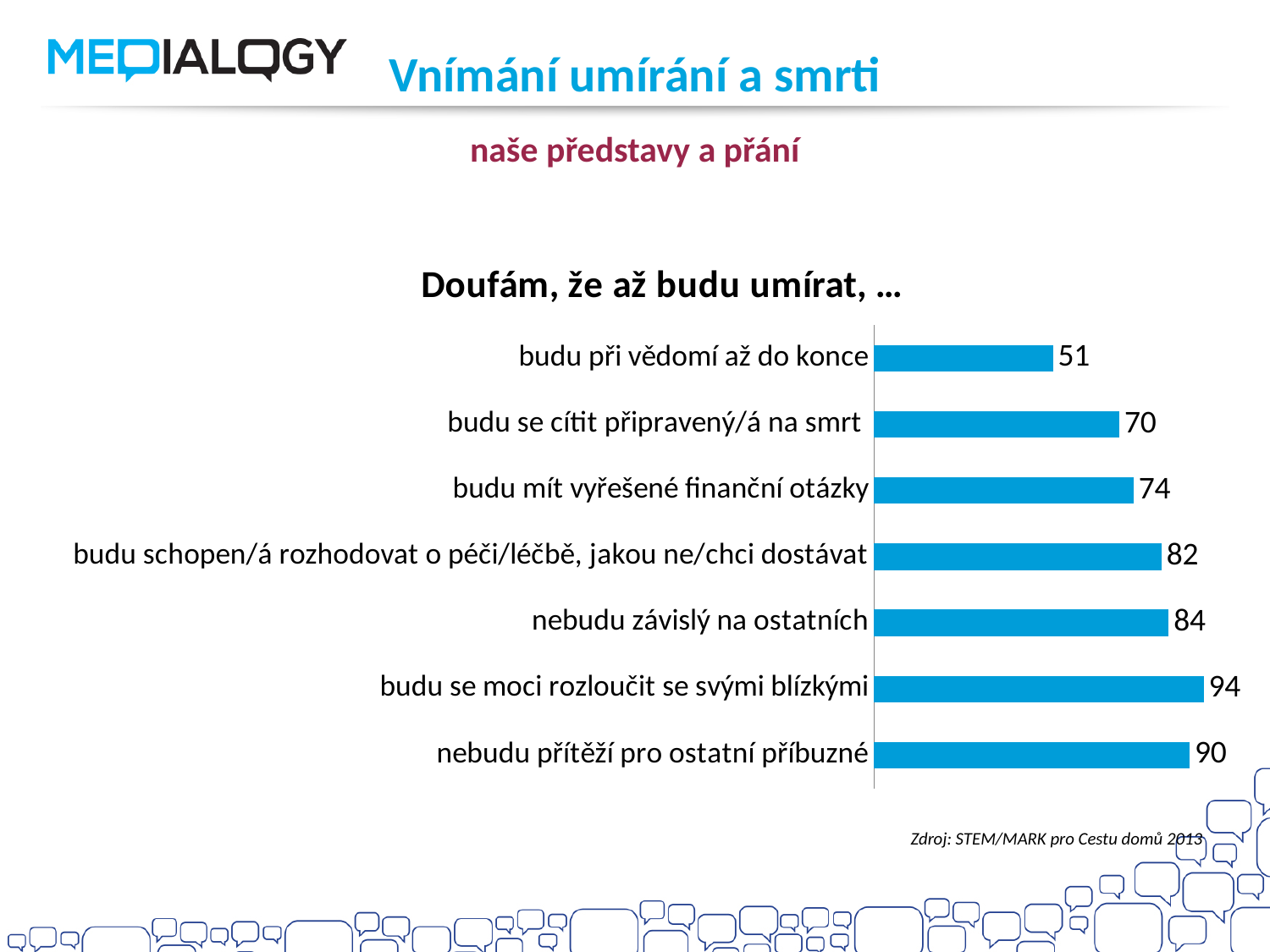
What is the difference between the values for "budu se moci rozloučit se svými blízkými" and "nebudu přítěží pro ostatní příbuzné"? 4 What kind of chart is shown on the slide? bar chart How many categories are shown in the chart? 7 What is the title of the chart? Doufám, že až budu umírat, … What is the difference between the values for "budu se cítit připravený/á na smrt" and "budu při vědomí až do konce"? 19 Which category has the lowest value? budu při vědomí až do konce Which category has the highest value? budu se moci rozloučit se svými blízkými Which is larger: the value for "budu schopen/á rozhodovat o péči/léčbě, jakou ne/chci dostávat" or the value for "budu mít vyřešené finanční otázky"? budu schopen/á rozhodovat o péči/léčbě, jakou ne/chci dostávat What is the value for "nebudu závislý na ostatních"? 84 What is the value for "budu při vědomí až do konce"? 51 What colour are the bars in the chart? blue What is the value for "budu mít vyřešené finanční otázky"? 74